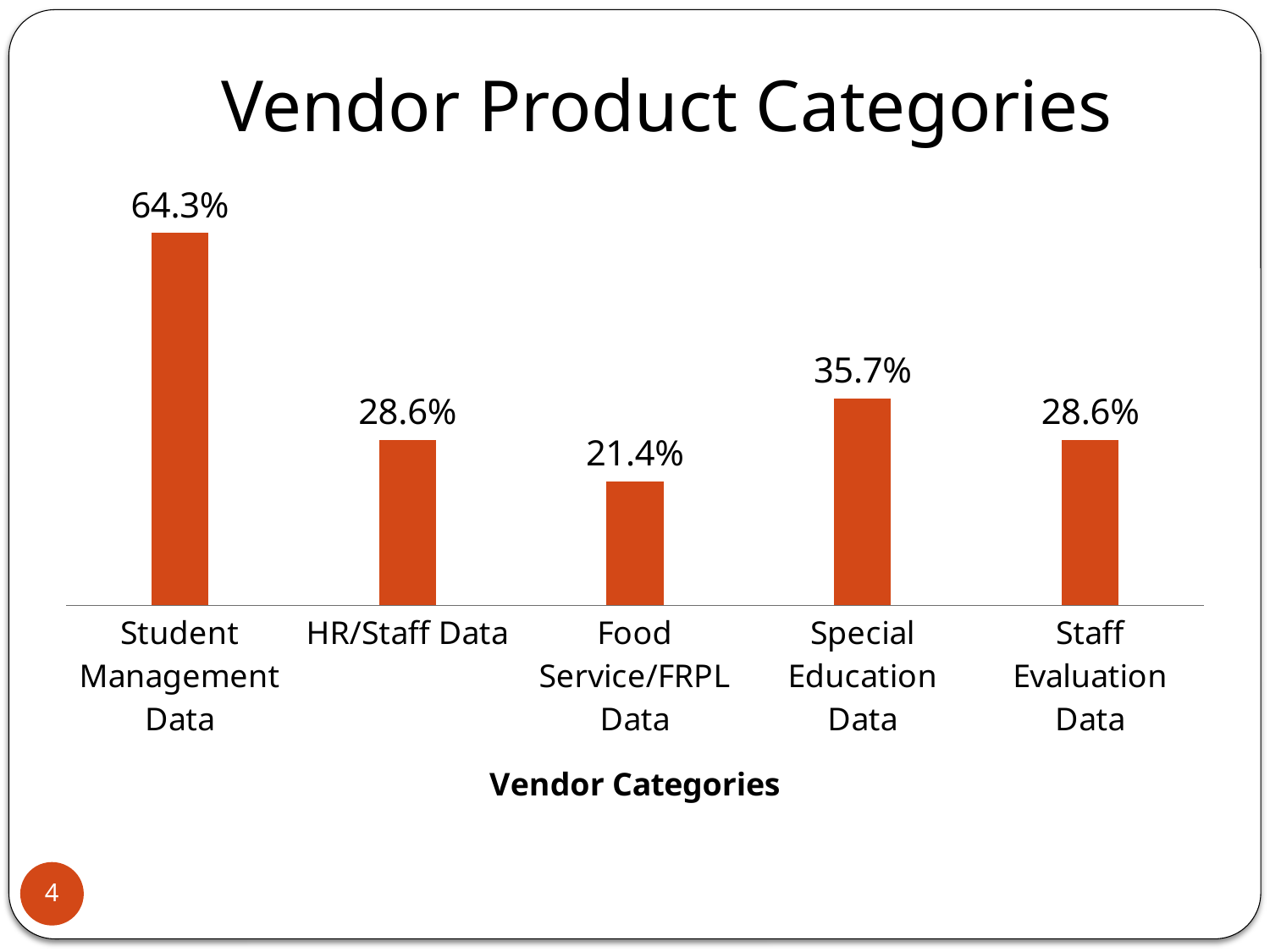
What is the value for HR/Staff Data? 28.6% Which is larger, the value for Special Education Data or the value for Staff Evaluation Data? Special Education Data What kind of chart is shown on the slide? Bar chart What is the difference between the values for Student Management Data and Special Education Data? 28.6% How many categories are shown in the chart? 5 What is the value for Food Service/FRPL Data? 21.4% Which category has the lowest value? Food Service/FRPL Data What is the value for Student Management Data? 64.3% What is the value for Special Education Data? 35.7% What is the x-axis title of the chart? Vendor Categories What is the difference between the values for HR/Staff Data and Food Service/FRPL Data? 7.2% Which category has the highest value? Student Management Data